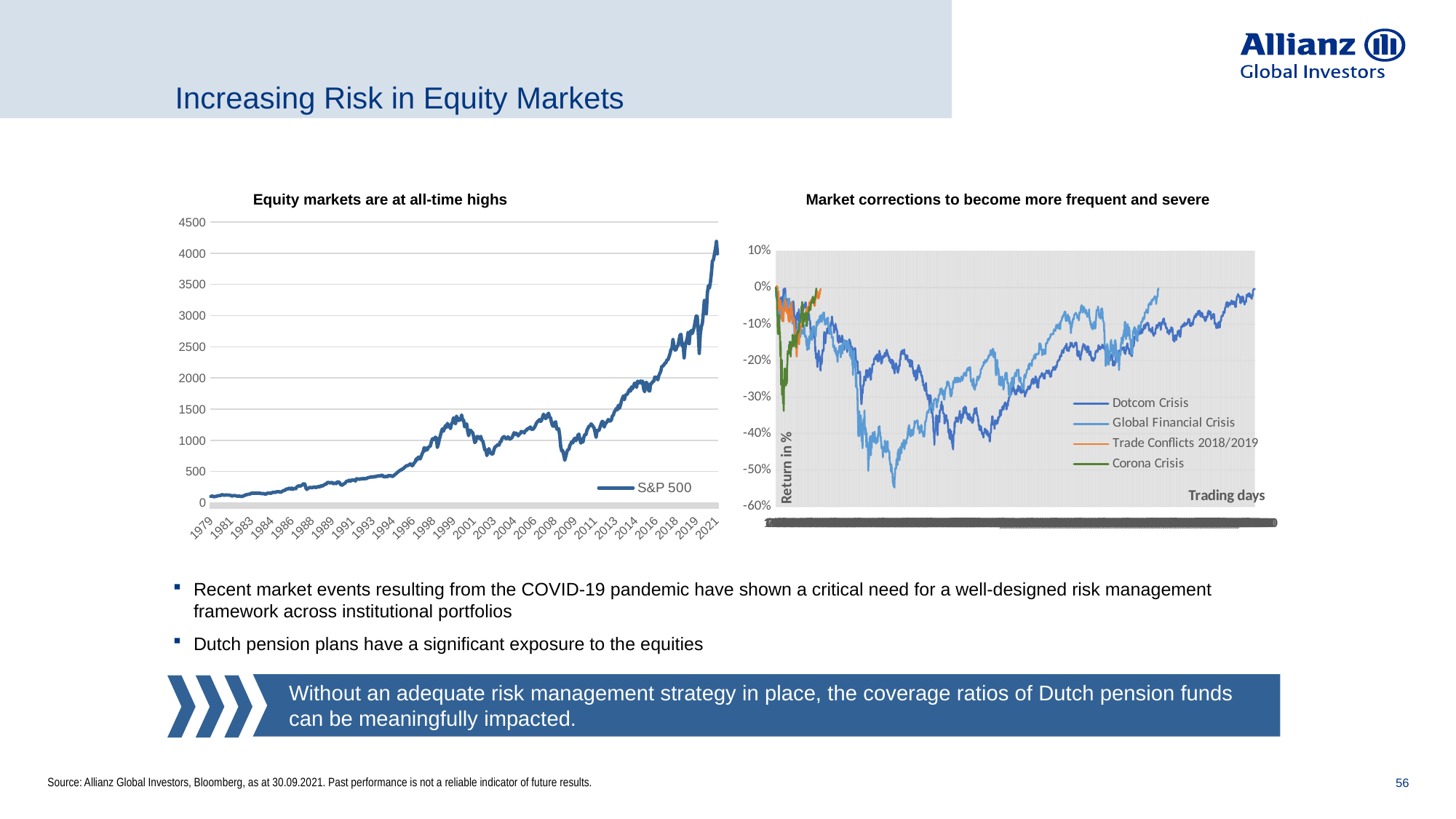
In the right chart "Market corrections to become more frequent and severe", which series reaches the lowest return? Global Financial Crisis In the left chart "Equity markets are at all-time highs", is the S&P 500 value at its 2009 low greater or less than 1000? less In the right chart "Market corrections to become more frequent and severe", what is the label of the vertical axis? Return in % What kind of chart is the left chart titled "Equity markets are at all-time highs"? line chart In the left chart "Equity markets are at all-time highs", does the S&P 500 generally rise or fall from 1979 to 2021? rise In the left chart "Equity markets are at all-time highs", is the S&P 500 value in 1979 greater or less than 500? less In the right chart "Market corrections to become more frequent and severe", is the lowest return of the Global Financial Crisis series greater or less than -50%? less In the left chart "Equity markets are at all-time highs", which series does the legend list? S&P 500 How many series does the legend list in the right chart "Market corrections to become more frequent and severe"? 4 What kind of chart is the right chart titled "Market corrections to become more frequent and severe"? line chart